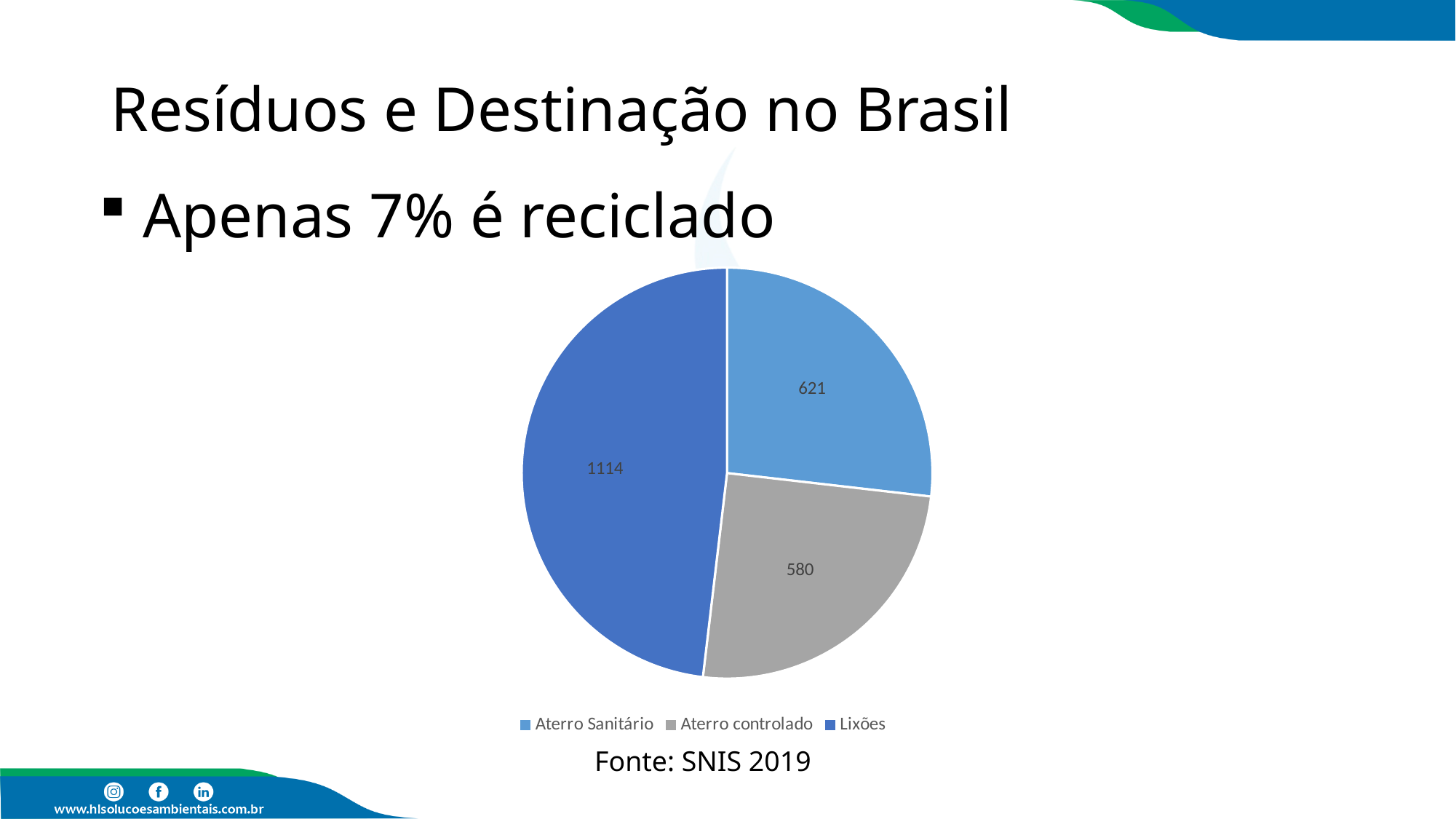
What is the value for Lixões in the pie chart? 1114 What source is cited below the pie chart? SNIS 2019 What kind of chart is shown on the slide? pie chart Which category has the smallest slice in the pie chart? Aterro controlado How many slices does the pie chart have? 3 What is the difference between the values for Aterro Sanitário and Aterro controlado? 41 What is the difference between the values for Lixões and Aterro Sanitário? 493 Which is larger, the value for Aterro Sanitário or the value for Aterro controlado? Aterro Sanitário Which category has the largest slice in the pie chart? Lixões What is the total of all the values shown in the pie chart? 2315 What is the value for Aterro controlado in the pie chart? 580 What is the value for Aterro Sanitário in the pie chart? 621